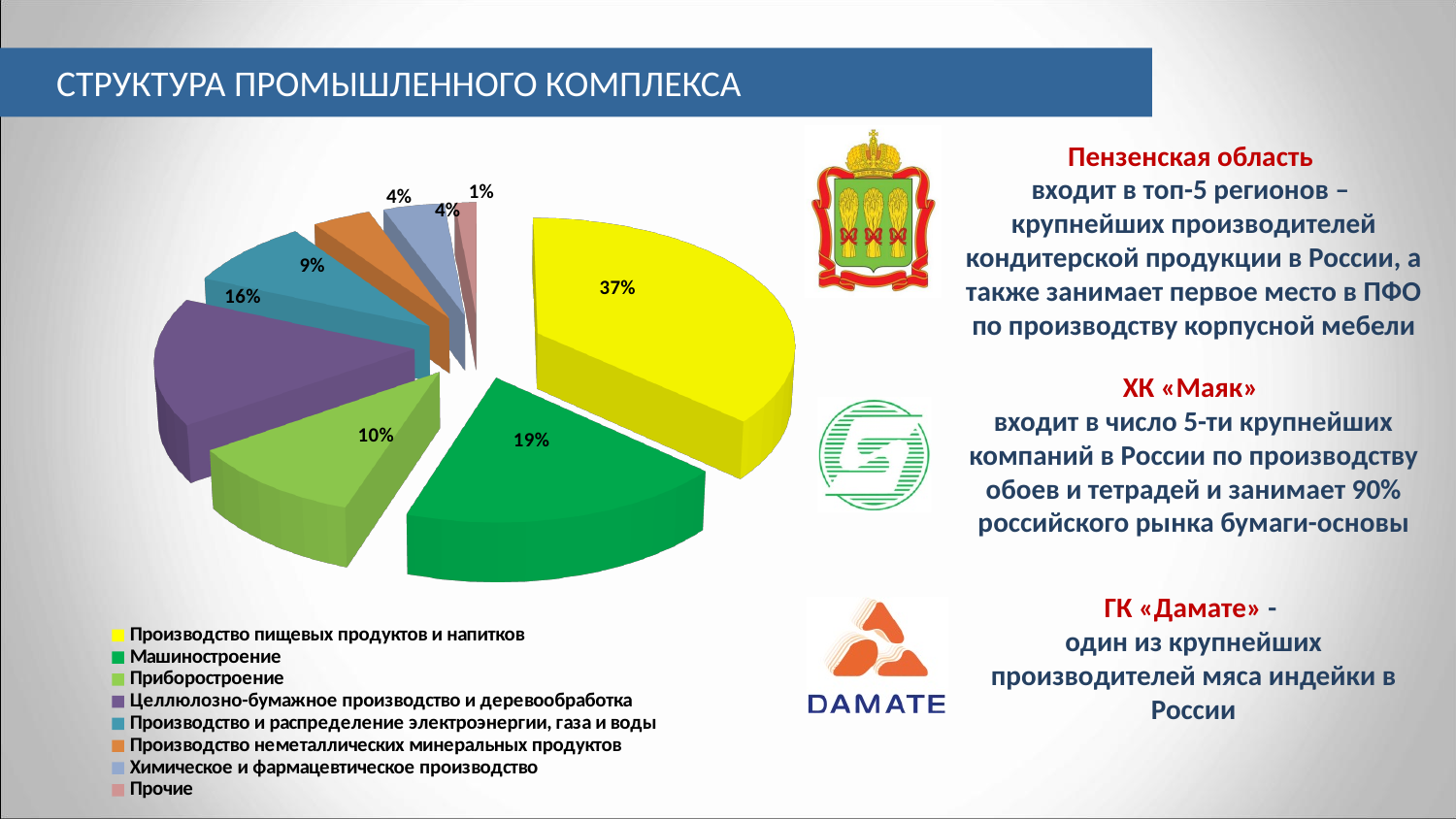
Which category has the largest slice of the pie? Производство пищевых продуктов и напитков What share of the pie does "Приборостроение" have? 10% What share of the pie does "Производство пищевых продуктов и напитков" have? 37% How many categories does the pie chart have? 8 Which is larger: the share for "Целлюлозно-бумажное производство и деревообработка" or the share for "Приборостроение"? Целлюлозно-бумажное производство и деревообработка Which category has the smallest slice of the pie? Прочие What share of the pie does "Машиностроение" have? 19% What is the difference in percentage points between "Производство пищевых продуктов и напитков" and "Машиностроение"? 18 What is the title of the slide containing the chart? СТРУКТУРА ПРОМЫШЛЕННОГО КОМПЛЕКСА What kind of chart is shown on the slide? Pie chart